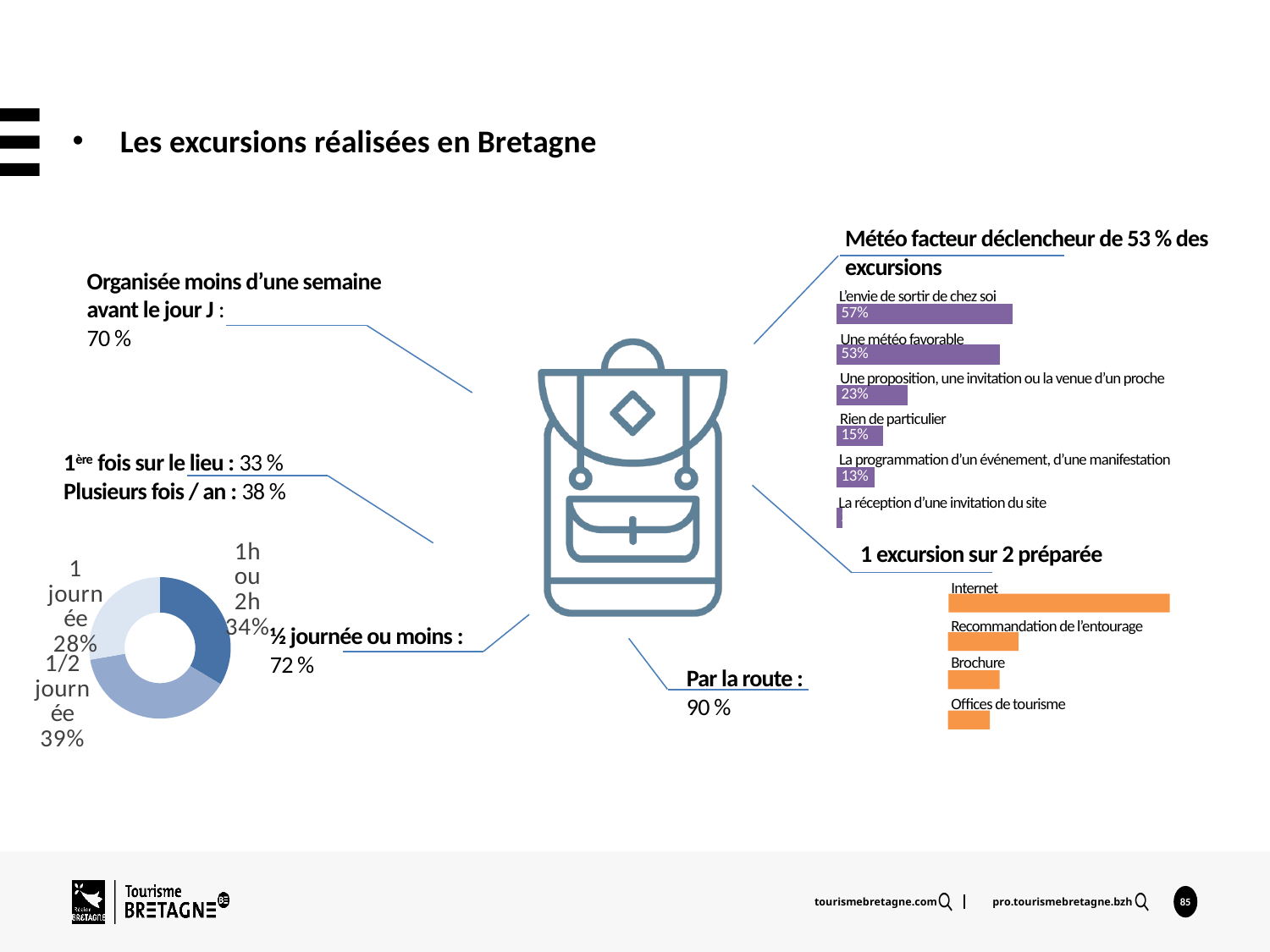
In the purple bar chart under 'Météo facteur déclencheur de 53 % des excursions', how many categories are shown? 6 In the donut chart on the left, what share is '1/2 journée'? 39% In the purple bar chart under 'Météo facteur déclencheur de 53 % des excursions', which category has the highest value? L'envie de sortir de chez soi In the purple bar chart under 'Météo facteur déclencheur de 53 % des excursions', what is the value for 'Une météo favorable'? 53% In the purple bar chart under 'Météo facteur déclencheur de 53 % des excursions', what is the difference between 'Une proposition, une invitation ou la venue d'un proche' and 'La programmation d'un événement, d'une manifestation'? 10% In the donut chart on the left, what share is '1 journée'? 28% In the purple bar chart under 'Météo facteur déclencheur de 53 % des excursions', what is the value for 'Rien de particulier'? 15% In the orange bar chart under '1 excursion sur 2 préparée', which category has the longest bar? Internet In the orange bar chart under '1 excursion sur 2 préparée', how many categories are shown? 4 In the donut chart on the left, which slice is the largest? 1/2 journée In the purple bar chart under 'Météo facteur déclencheur de 53 % des excursions', what is the value for 'L'envie de sortir de chez soi'? 57% In the purple bar chart under 'Météo facteur déclencheur de 53 % des excursions', which category has the shortest bar? La réception d'une invitation du site